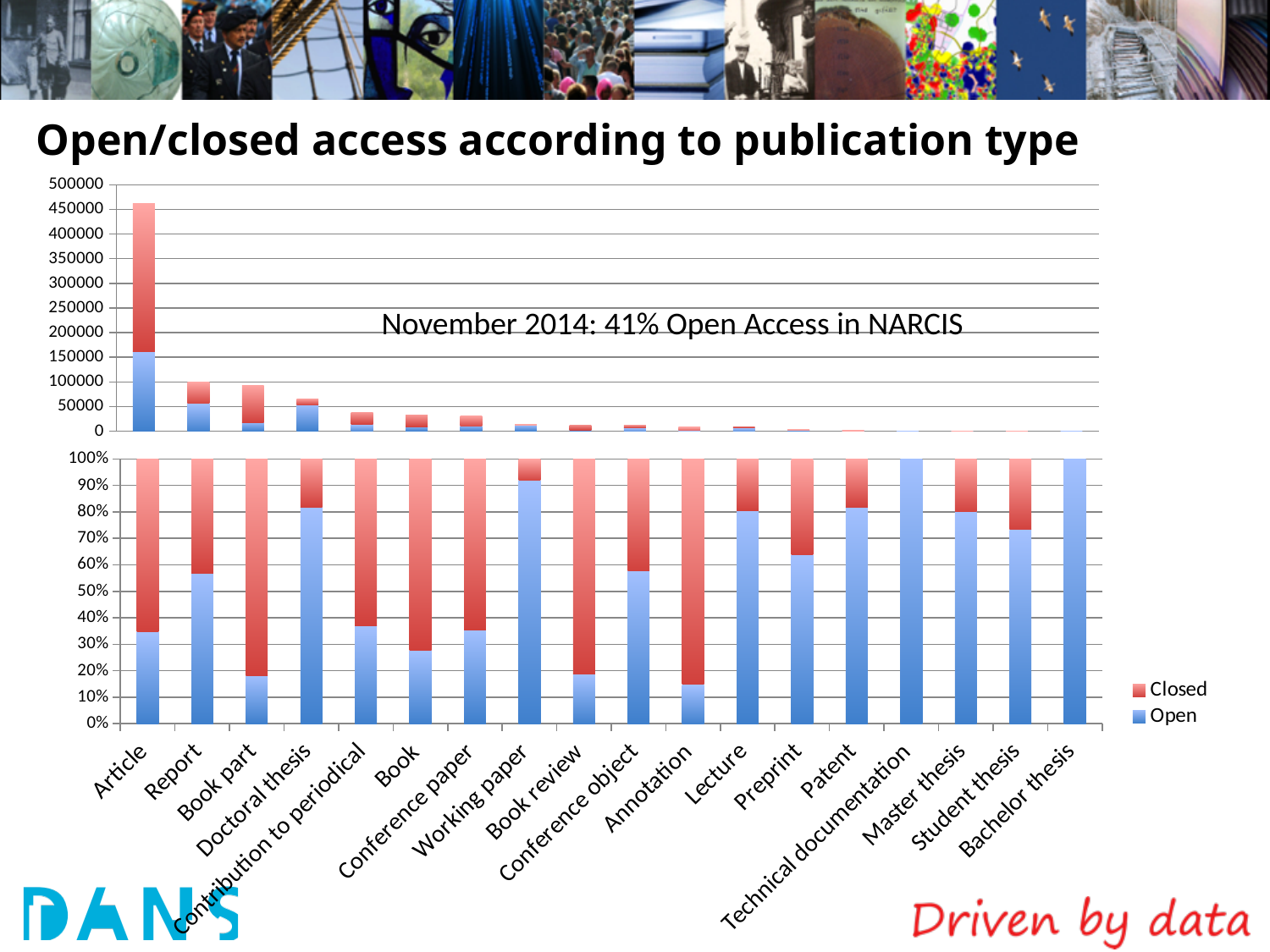
In the bottom chart, is the Open share for Working paper greater or less than 90%? greater In the top chart, is the total bar for Article greater or less than 400000? greater In the bottom chart, which colour represents the Closed series? red In the bottom chart, is the Open share for Article greater or less than 40%? less How many series does the legend of the bottom chart list? 2 In the bottom chart, which has the larger Open share, Doctoral thesis or Article? Doctoral thesis In the top chart, which publication type has the highest total number of publications? Article How many publication types are shown along the x axis of the bottom chart? 18 What kind of chart is the bottom chart on the slide? stacked bar chart What overall Open Access percentage for NARCIS in November 2014 is stated on the slide? 41%